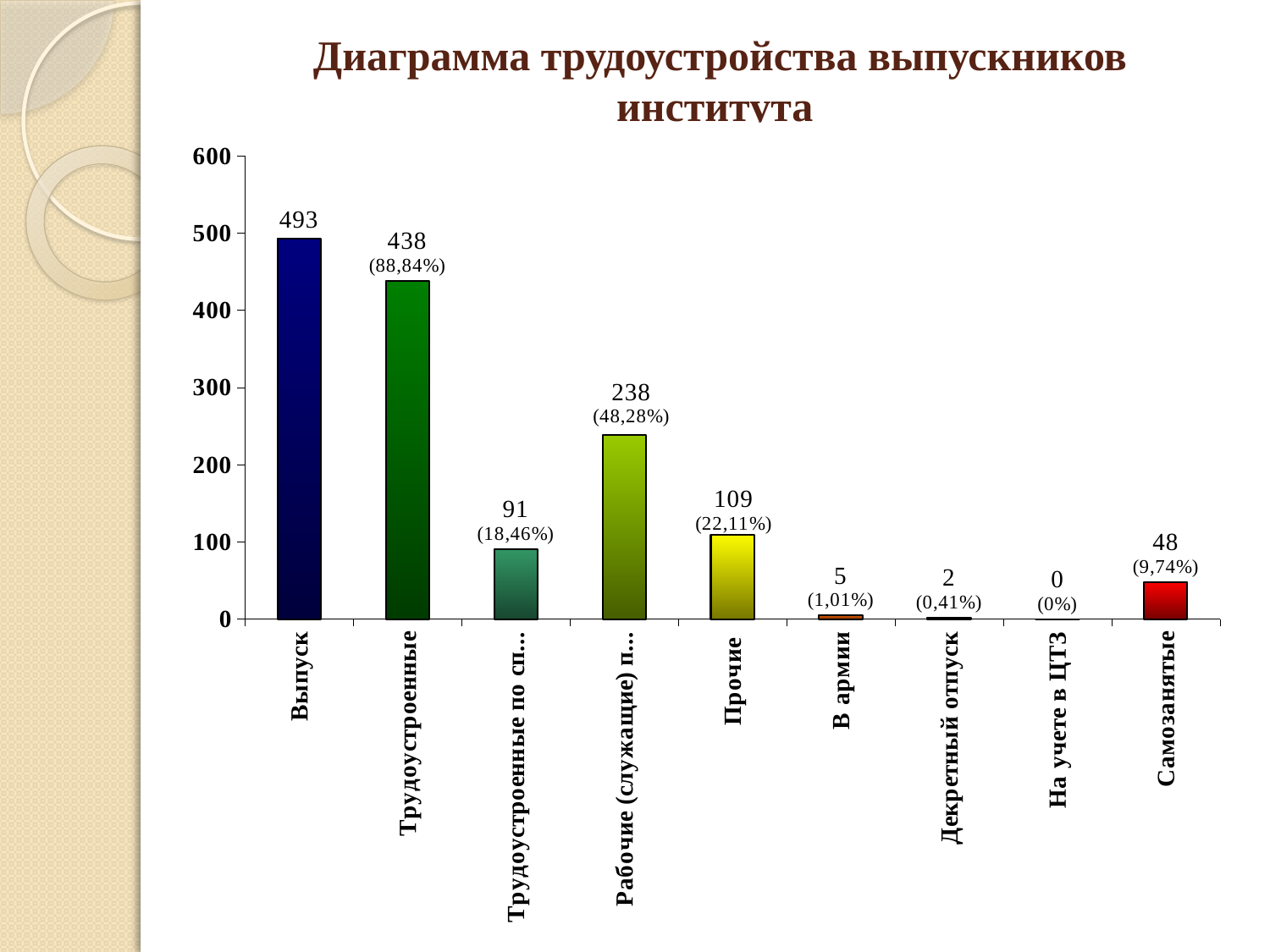
What is the value for Выпуск? 493 What is the value for Трудоустроенные? 438 How many categories are shown on the chart? 9 Which category has the highest value? Выпуск What is the value for Самозанятые? 48 Is the value for Рабочие (служащие) greater or less than 200? greater Which is larger, the value for Прочие or the value for Самозанятые? Прочие Which category has the lowest value? На учете в ЦТЗ What percentage is shown for Прочие? 22,11% What kind of chart is shown on the slide? bar chart What is the value for В армии? 5 What is the difference between the values for Выпуск and Трудоустроенные? 55